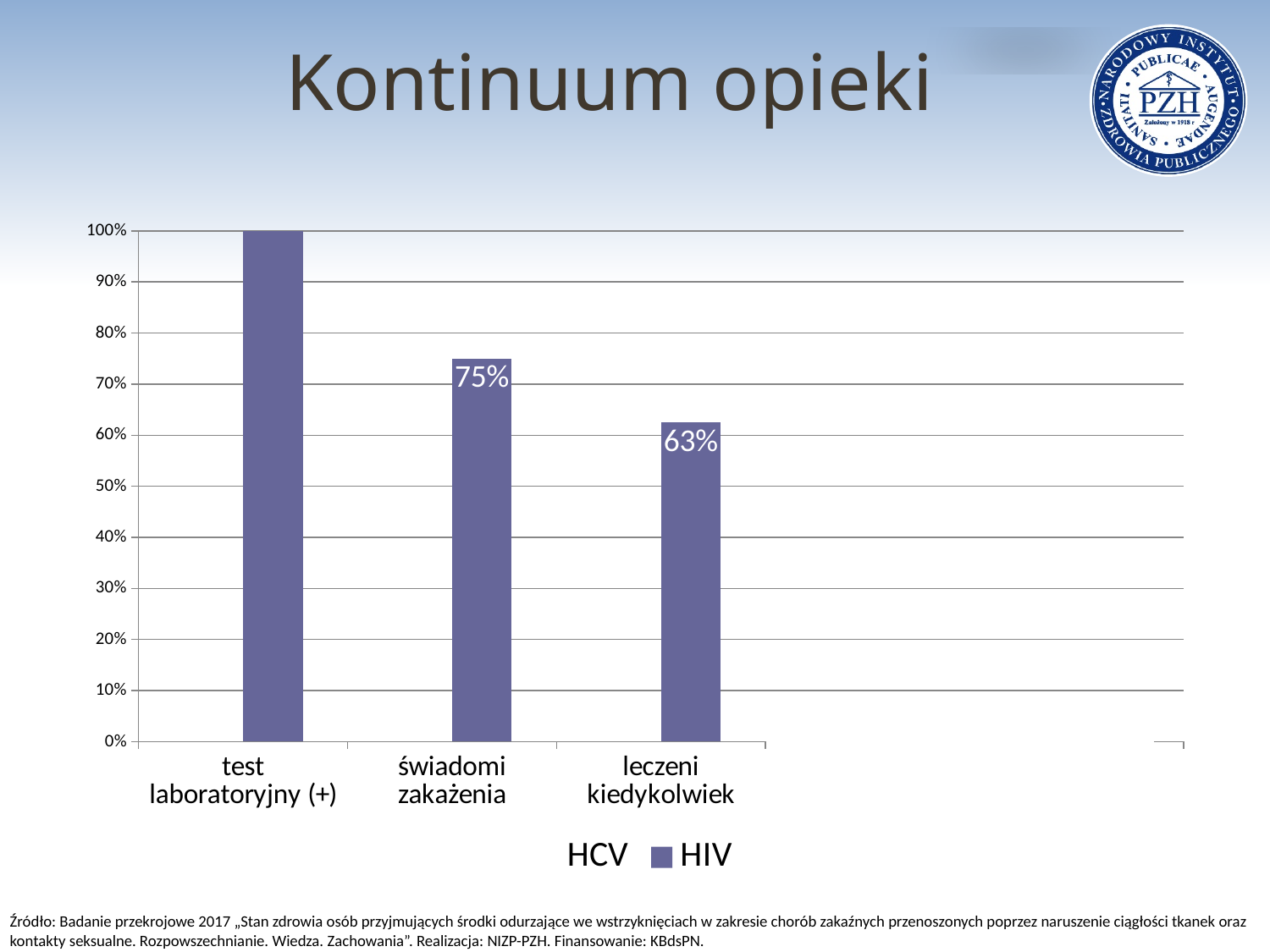
How many categories are shown on the x axis of the chart? 3 What kind of chart is shown on the slide? bar chart What is the value for "leczeni kiedykolwiek" in the chart? 63% What is the value for "świadomi zakażenia" in the chart? 75% Is the value for "test laboratoryjny (+)" greater or less than 90%? greater What is the difference between the values for "świadomi zakażenia" and "leczeni kiedykolwiek"? 12 percentage points Which category has the highest value in the chart? test laboratoryjny (+) Do the values rise or fall from left to right along the x axis? fall Which category has the lowest value in the chart? leczeni kiedykolwiek How many series does the chart legend list? 2 What is the value for "test laboratoryjny (+)" in the chart? 100% Which is larger: the value for "świadomi zakażenia" or the value for "leczeni kiedykolwiek"? świadomi zakażenia